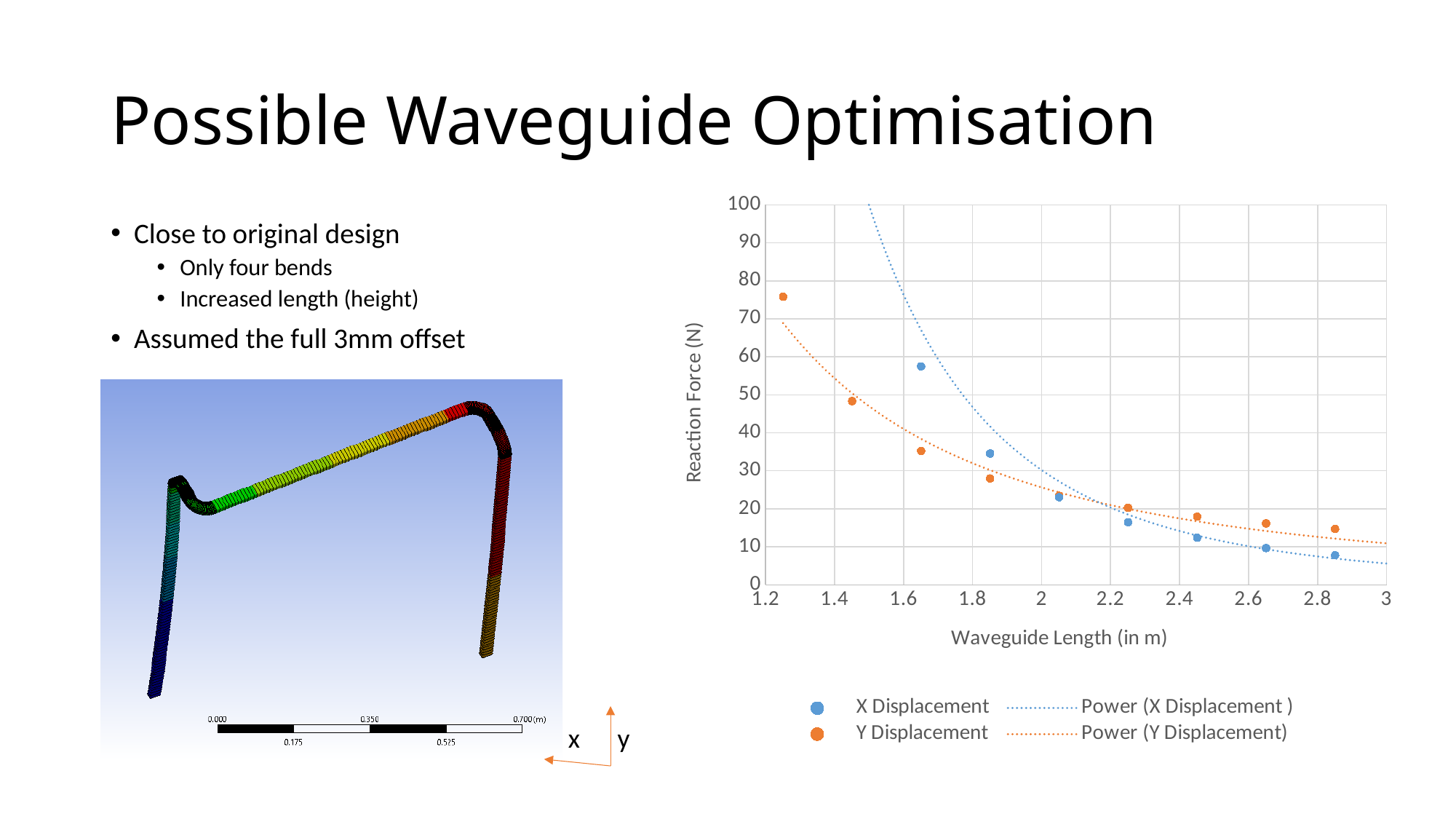
How many X Displacement data points are plotted? 7 Do the Y Displacement reaction force values rise or fall as waveguide length increases? Fall What kind of chart is shown on the slide? Scatter chart At a waveguide length of about 2.85 m, which series has the larger reaction force, X Displacement or Y Displacement? Y Displacement How many Y Displacement data points are plotted? 9 What is the title of the chart's horizontal axis? Waveguide Length (in m) Is the reaction force for the leftmost Y Displacement point (near 1.25 m) greater or less than 70? greater Is the reaction force for the rightmost X Displacement point (near 2.85 m) greater or less than 10? less How many entries does the chart legend list? 4 At a waveguide length of about 1.65 m, which series has the larger reaction force, X Displacement or Y Displacement? X Displacement Do the X Displacement reaction force values rise or fall as waveguide length increases? Fall What is the title of the chart's vertical axis? Reaction Force (N)